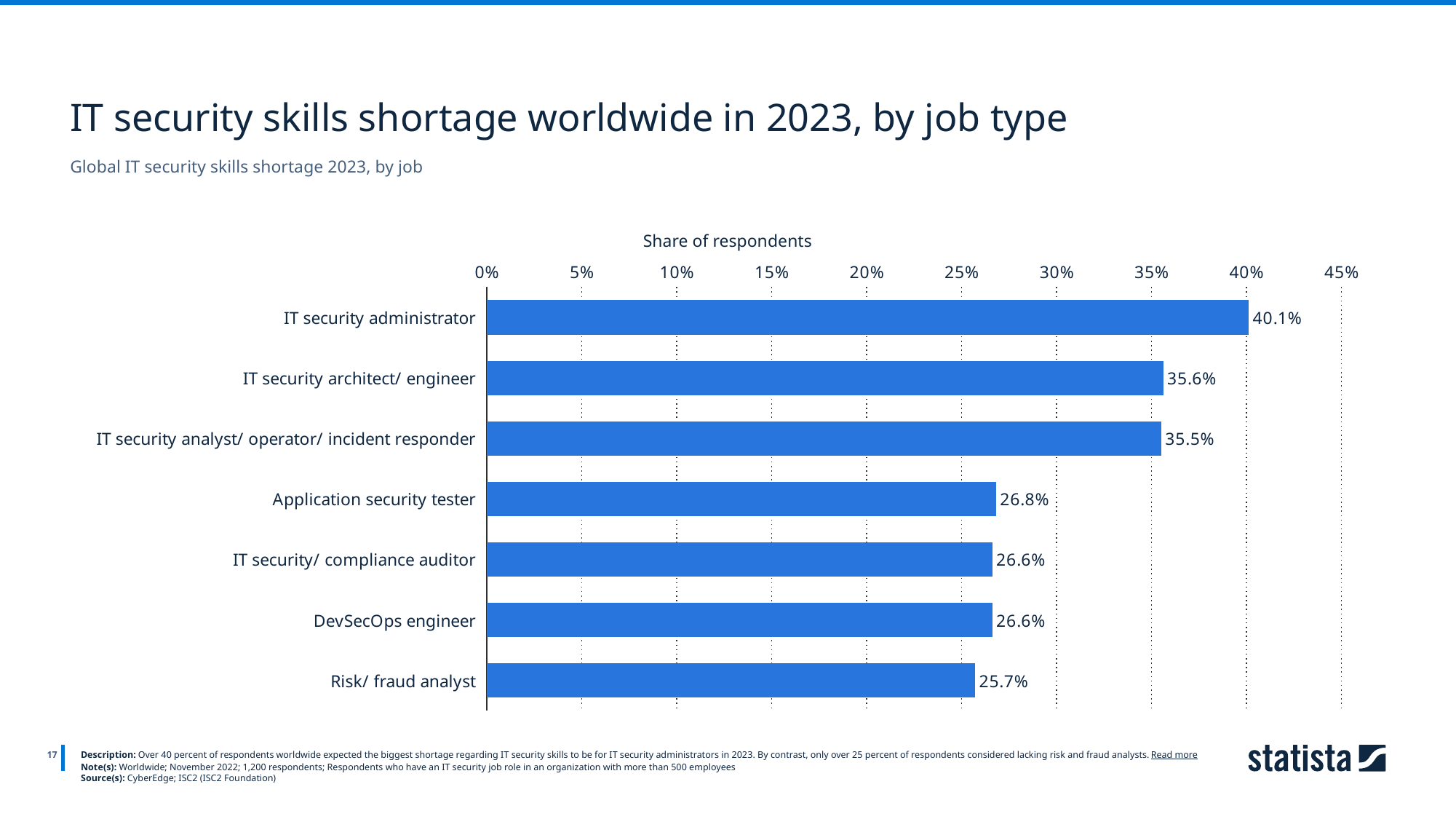
Which job type has the lowest share of respondents? Risk/ fraud analyst How many job types are shown in the chart? 7 Is the value for IT security analyst/ operator/ incident responder greater or less than 30%? greater Which job type has the highest share of respondents? IT security administrator What is the label of the horizontal axis of the chart? Share of respondents Which has a larger share of respondents, IT security architect/ engineer or Application security tester? IT security architect/ engineer What is the difference between the shares for IT security administrator and IT security architect/ engineer? 4.5% What kind of chart is shown on the slide? Bar chart What is the share of respondents for IT security administrator? 40.1% What is the share of respondents for Application security tester? 26.8% What is the difference between the shares for Application security tester and Risk/ fraud analyst? 1.1% What is the share of respondents for Risk/ fraud analyst? 25.7%